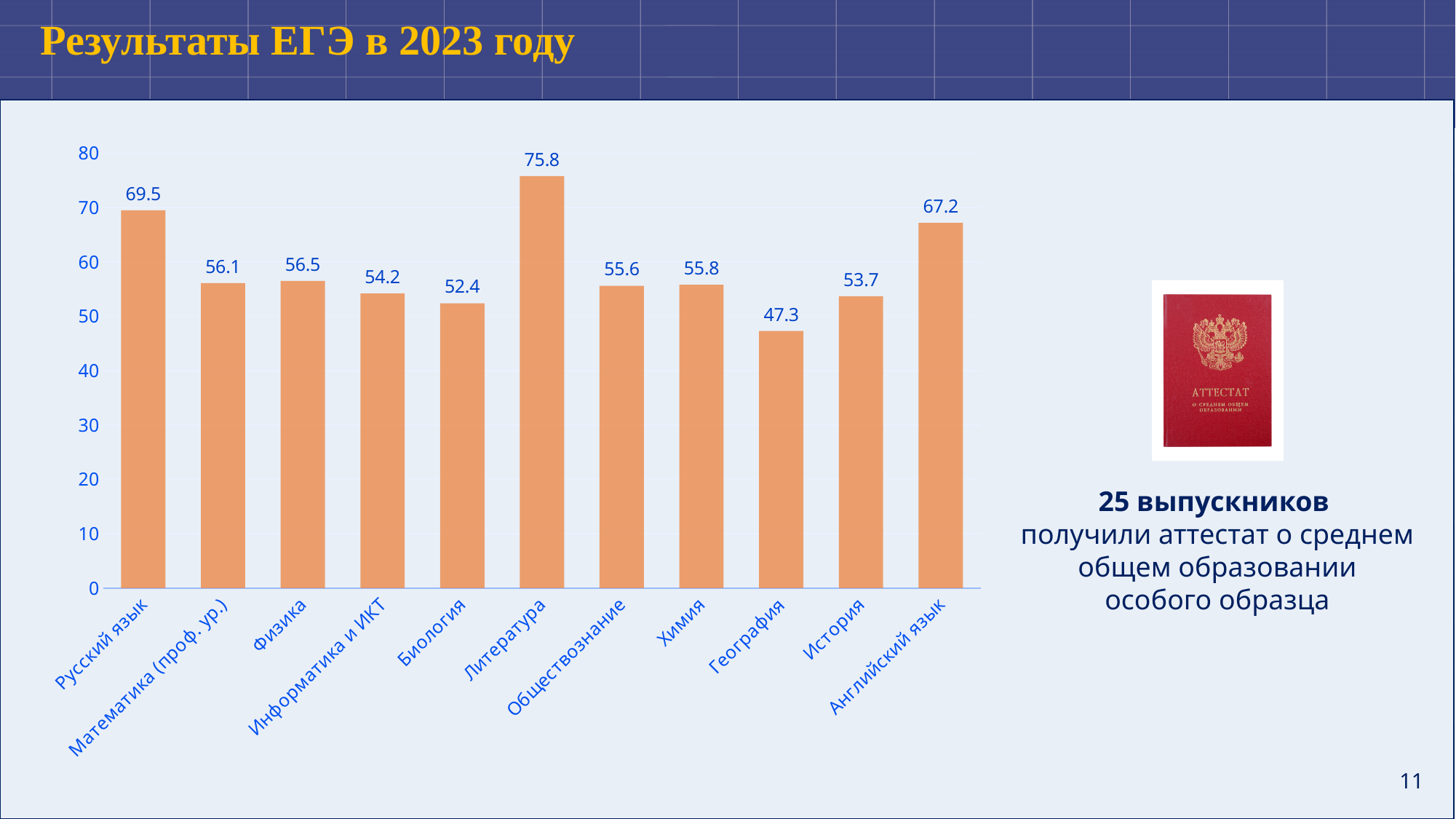
Is the value for Химия greater or less than 60? less Which is larger, the value for Физика or the value for Биология? Физика How many subjects are shown in the chart? 11 What is the value for Информатика и ИКТ? 54.2 What is the difference between the values for Английский язык and История? 13.5 Which subject has the lowest value? География What is the value for География? 47.3 What is the value for Литература? 75.8 Which subject has the highest value? Литература What is the difference between the values for Литература and Русский язык? 6.3 What is the value for Русский язык? 69.5 What kind of chart is shown on the slide? bar chart